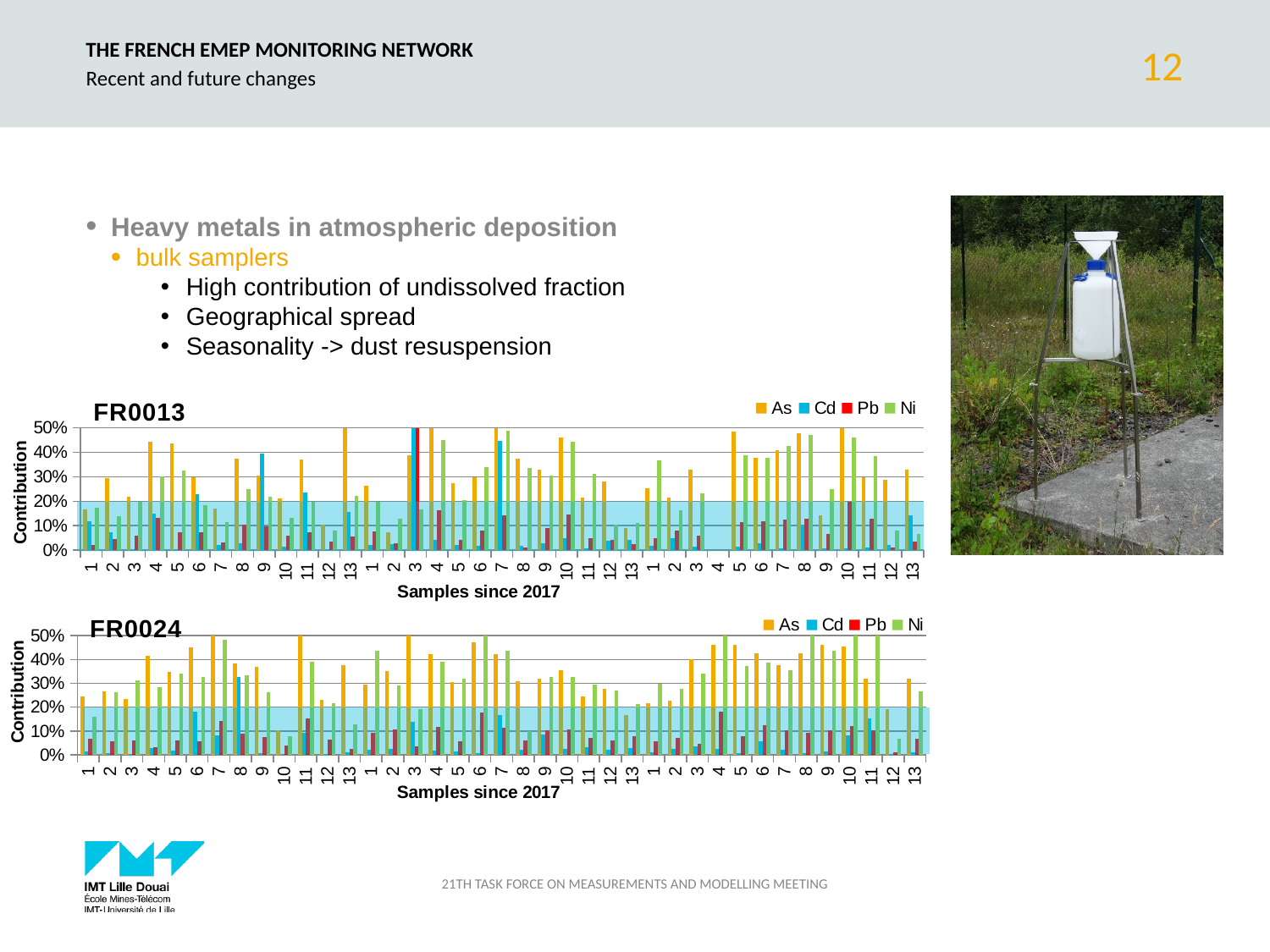
How many sample categories are shown along the x axis of the FR0013 chart? 39 In the FR0013 chart, is the Cd value for the first sample 9 greater or less than 30%? greater What is the x-axis title of the FR0013 chart? Samples since 2017 In the FR0013 chart, which is larger for the first sample 13: the As value or the Cd value? As In the FR0024 chart, is the As value for the first sample 11 greater or less than 40%? greater How many series does the legend of the FR0013 chart list? 4 What kind of chart is the FR0013 chart? bar chart What are the series names in the legend of the FR0024 chart? As, Cd, Pb, Ni How many series does the legend of the FR0024 chart list? 4 What kind of chart is the FR0024 chart? bar chart In the FR0013 chart, is the As value for the first sample 4 greater or less than 30%? greater